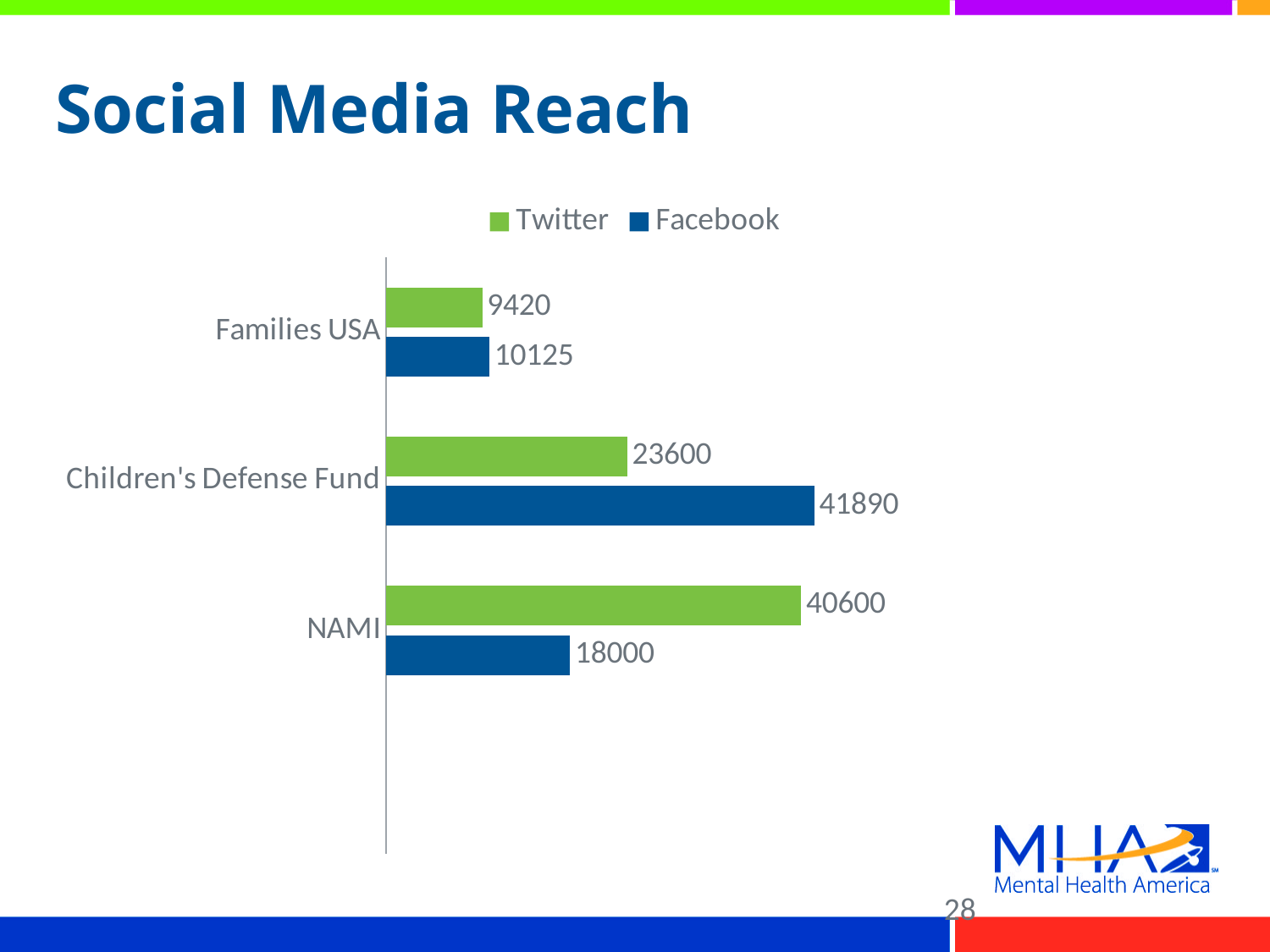
What is the Facebook value for Children's Defense Fund? 41890 What is the difference between the Facebook and Twitter values for Children's Defense Fund? 18290 What is the Twitter value for NAMI? 40600 Which organization has the highest Twitter value? NAMI What kind of chart is shown on the slide? Bar chart How many organizations are shown on the chart? 3 What is the Twitter value for Children's Defense Fund? 23600 How many series does the legend list? 2 Which organization has the lowest Facebook value? Families USA Which is larger for Families USA, the Twitter value or the Facebook value? Facebook What is the Facebook value for Families USA? 10125 What is the difference between the Twitter and Facebook values for NAMI? 22600